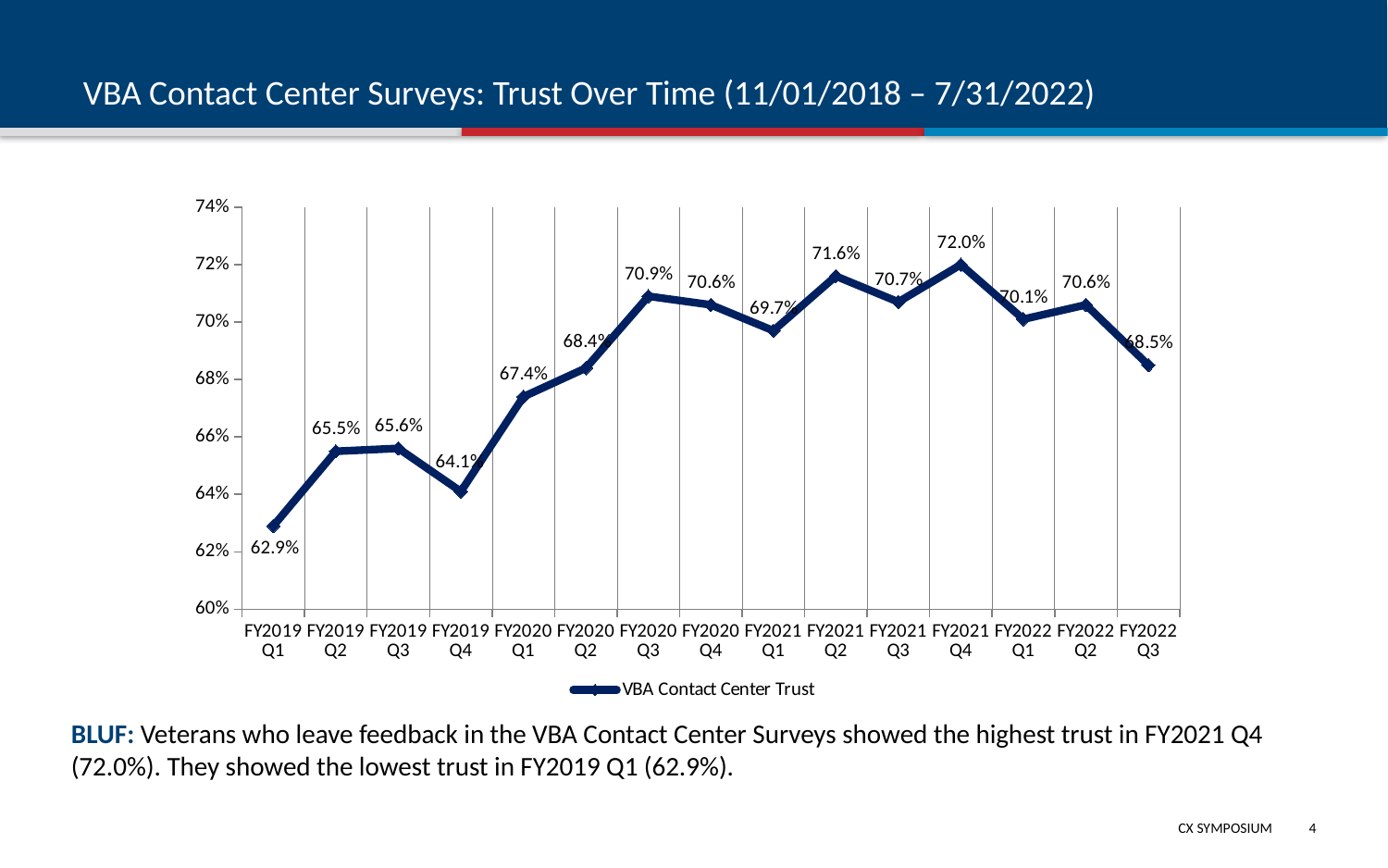
How many series does the legend list? 1 How many quarters are plotted on the chart? 15 Which quarter has the highest trust value? FY2021 Q4 What is the VBA Contact Center Trust value for FY2020 Q3? 70.9% Which is larger, the trust value for FY2020 Q1 or FY2022 Q1? FY2022 Q1 What is the trust value for FY2019 Q4? 64.1% Which quarter has the lowest trust value? FY2019 Q1 What kind of chart is shown on the slide? line chart What is the difference between the trust values for FY2021 Q4 and FY2019 Q1? 9.1% Is the trust value for FY2019 Q2 greater or less than 66%? less What is the trust value for FY2022 Q3? 68.5% What is the title of the chart? VBA Contact Center Surveys: Trust Over Time (11/01/2018 – 7/31/2022)